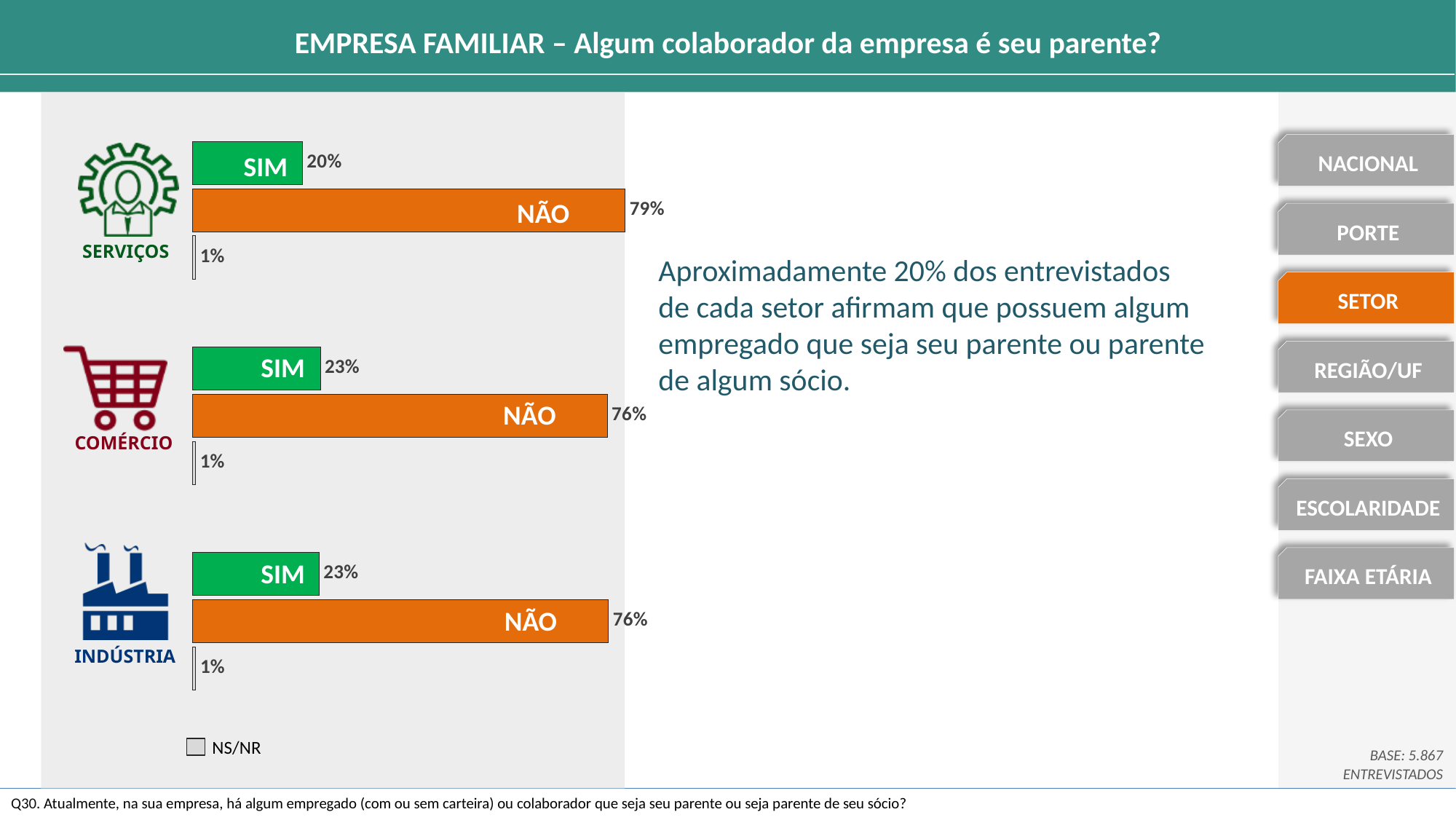
What type of chart is used to show the SIM and NÃO responses? Bar chart Which sector has the lowest SIM percentage? SERVIÇOS What percentage of INDÚSTRIA respondents answered NÃO? 76% Which sector has the highest NÃO percentage? SERVIÇOS What percentage of SERVIÇOS respondents answered NÃO? 79% What colour are the NÃO bars? Orange Which is larger for INDÚSTRIA, the SIM percentage or the NÃO percentage? NÃO What is the NS/NR percentage for COMÉRCIO? 1% What percentage of SERVIÇOS respondents answered SIM? 20% How many sectors are shown in the chart? 3 What is the difference between the NÃO and SIM percentages for SERVIÇOS? 59 percentage points What percentage of COMÉRCIO respondents answered SIM? 23%